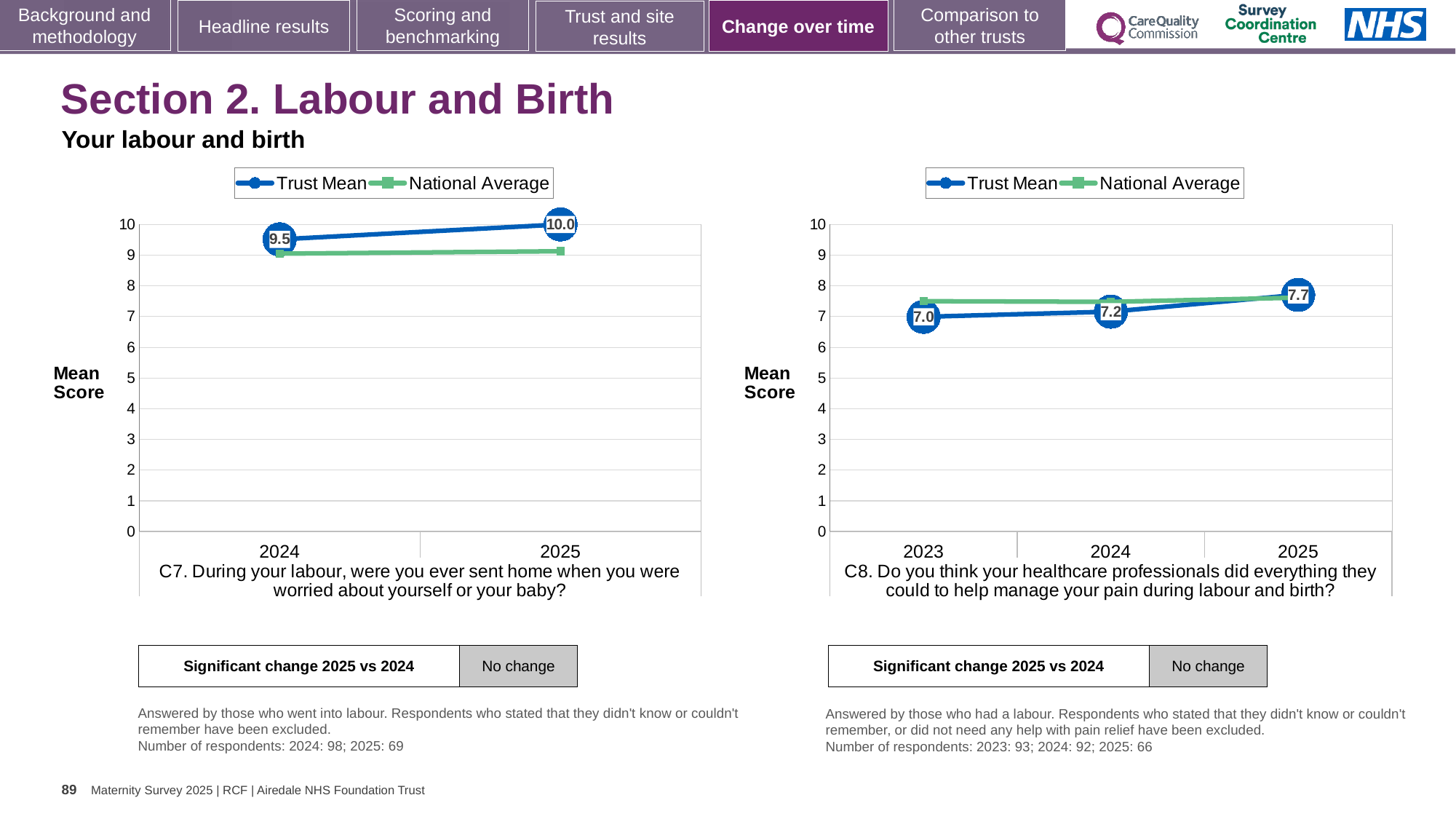
How many years are shown on the x axis of the right chart (C8)? 3 In the left chart (C7), what is the Trust Mean for 2024? 9.5 In the right chart (C8), which year has the highest Trust Mean? 2025 In the right chart (C8), what is the Trust Mean for 2025? 7.7 In the right chart (C8), what is the difference between the Trust Mean in 2025 and in 2023? 0.7 In the right chart (C8), which year has the lowest Trust Mean? 2023 How many series does the legend of the left chart (C7) list? 2 In the left chart (C7), does the Trust Mean rise or fall from 2024 to 2025? rise In the left chart (C7), is the National Average for 2024 greater or less than 8? greater In the left chart (C7), by how much did the Trust Mean change from 2024 to 2025? 0.5 In the right chart (C8), what is the Trust Mean for 2023? 7.0 In the left chart (C7), what is the Trust Mean for 2025? 10.0